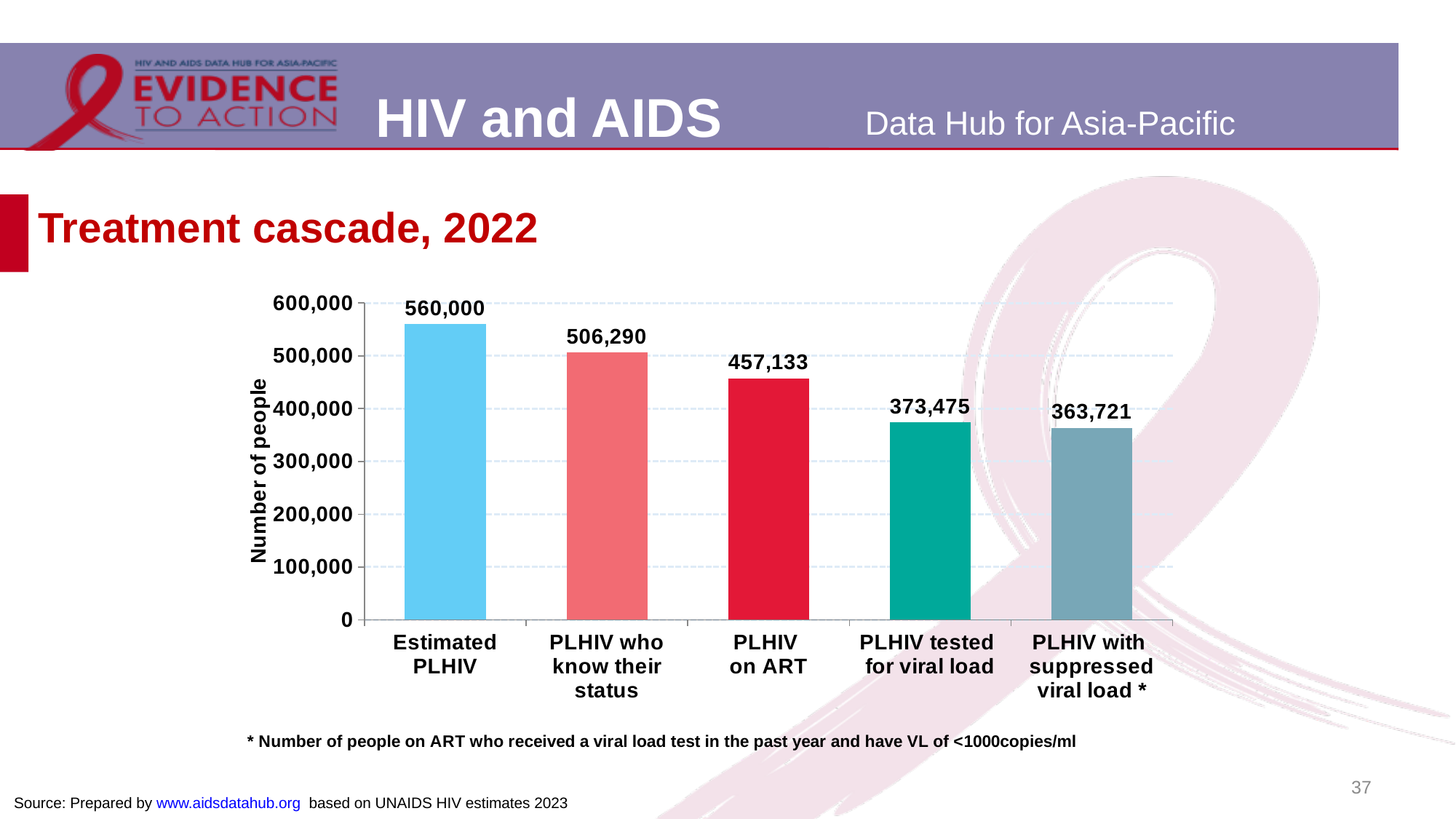
Which category has the highest value? Estimated PLHIV How many categories are shown in the chart? 5 What is the value for PLHIV on ART? 457,133 What is the difference between Estimated PLHIV and PLHIV on ART? 102,867 What is the value for Estimated PLHIV? 560,000 Which category has the lowest value? PLHIV with suppressed viral load Which is larger, PLHIV who know their status or PLHIV tested for viral load? PLHIV who know their status Do the values rise or fall from left to right across the categories? Fall What is the value for PLHIV with suppressed viral load? 363,721 What kind of chart is shown on the slide? Bar chart What is the value for PLHIV who know their status? 506,290 What is the value for PLHIV tested for viral load? 373,475